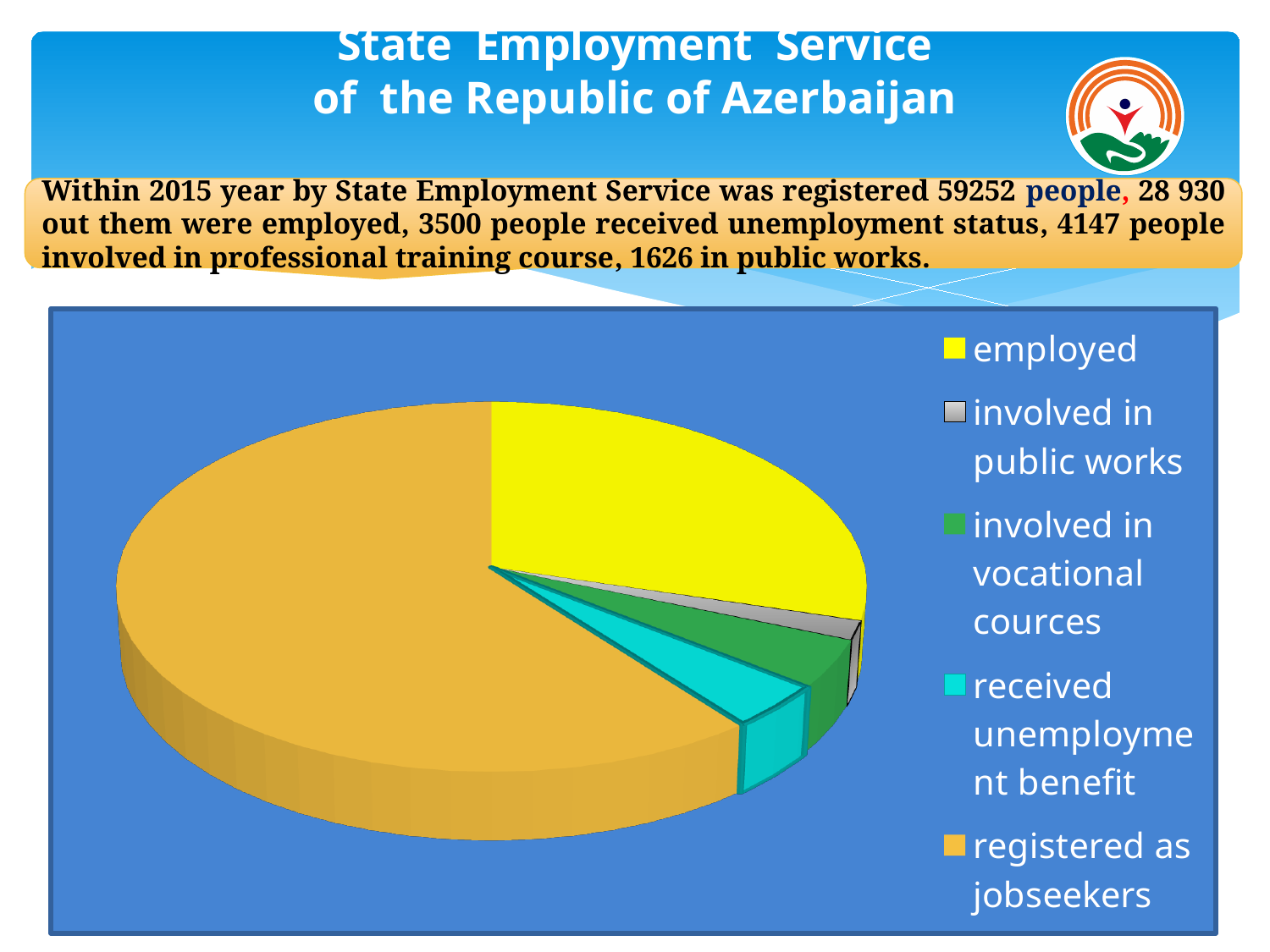
Which category has the smallest slice in the pie chart? involved in public works How many categories does the legend of the pie chart list? 5 Which slice is larger in the pie chart: registered as jobseekers or employed? registered as jobseekers Which slice is larger in the pie chart: involved in vocational cources or involved in public works? involved in vocational cources What colour is the 'employed' slice in the pie chart? yellow How many slices does the pie chart have? 5 What kind of chart is shown on the slide? pie chart Which slice is larger in the pie chart: employed or received unemployment benefit? employed Which category is shown in orange in the pie chart? registered as jobseekers Which category has the largest slice in the pie chart? registered as jobseekers